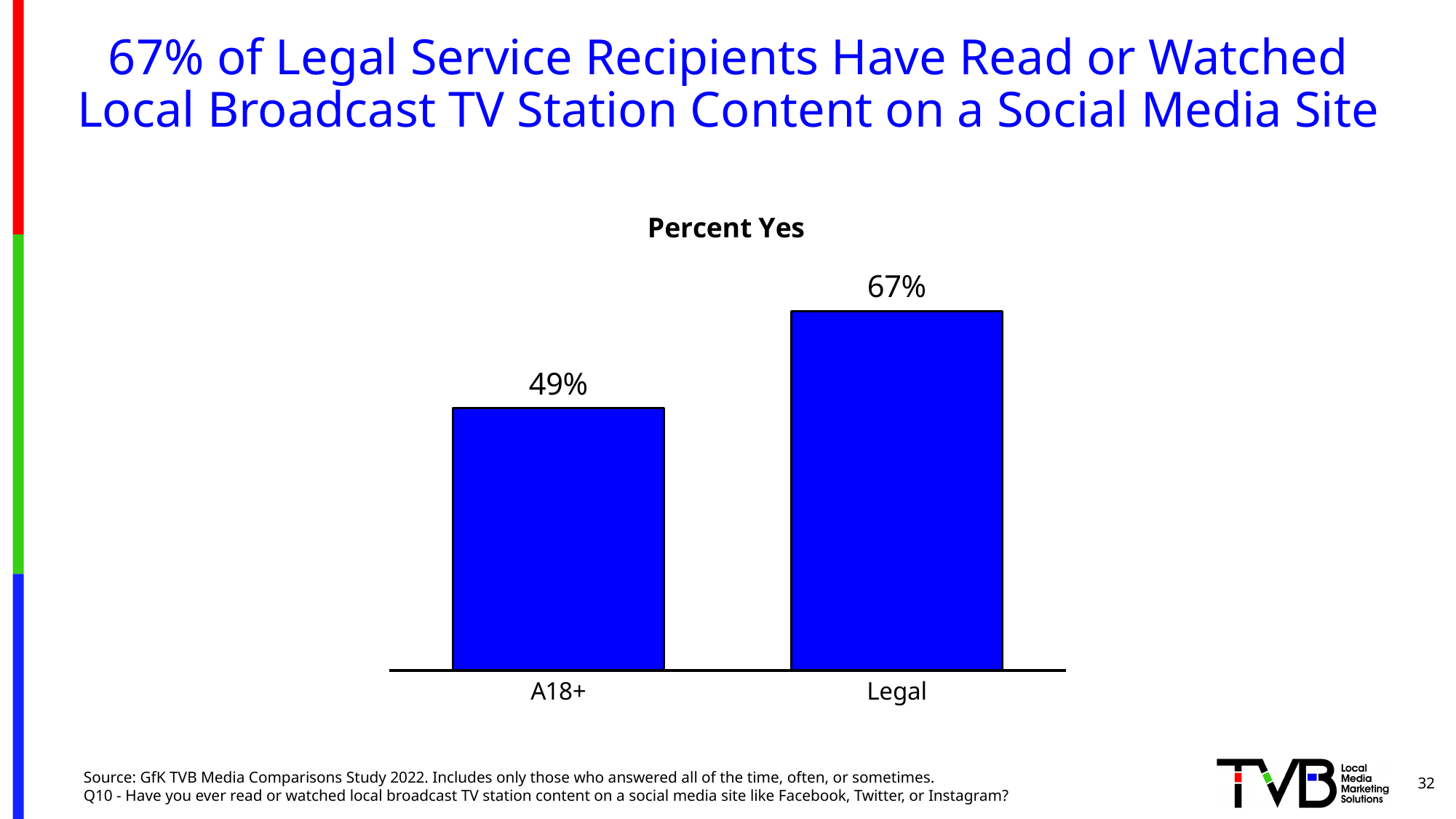
Do the values rise or fall from A18+ to Legal? Rise What is the difference in Percent Yes between Legal and A18+? 18% What is the Percent Yes value for A18+? 49% What kind of chart is shown on the slide? Bar chart Which category has the lowest Percent Yes value? A18+ What colour are the bars in the chart? Blue How many categories are shown in the chart? 2 What is the title of the chart? Percent Yes Which is larger, the Percent Yes value for A18+ or for Legal? Legal Which category has the highest Percent Yes value? Legal What is the Percent Yes value for Legal? 67%